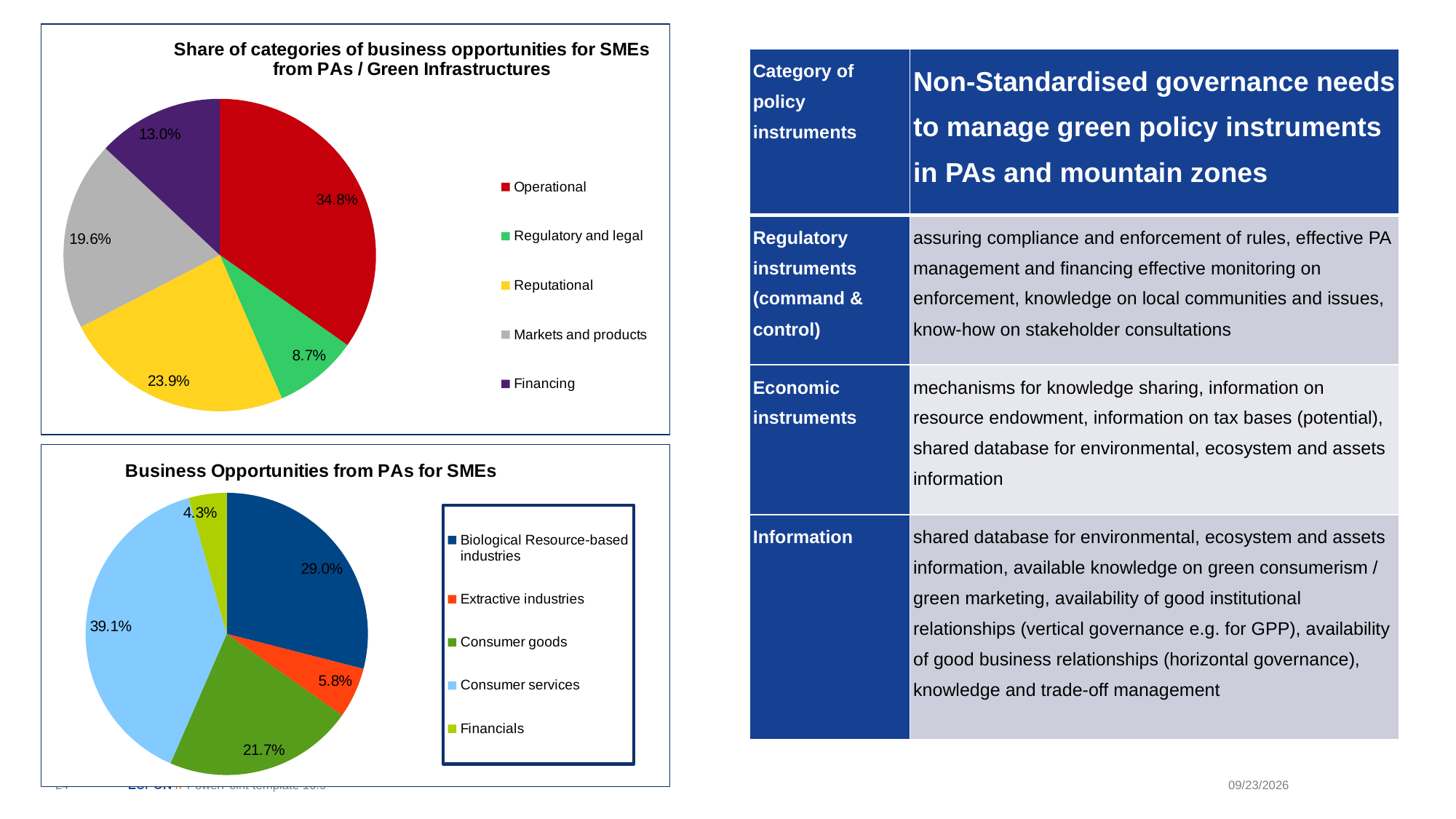
In the top chart, what is the difference between the Reputational share and the Financing share? 10.9% In the bottom chart, what share do Extractive industries have? 5.8% In the top chart, 'Share of categories of business opportunities for SMEs from PAs / Green Infrastructures', what share does Operational have? 34.8% In the top chart, what share does Markets and products have? 19.6% What type of chart is the bottom chart, 'Business Opportunities from PAs for SMEs'? Pie chart In the top chart, which category has the largest share? Operational In the bottom chart, what is the difference between the Consumer services share and the Biological Resource-based industries share? 10.1% In the bottom chart, which category has the smallest share? Financials In the bottom chart, 'Business Opportunities from PAs for SMEs', what share do Consumer services have? 39.1% In the bottom chart, which is larger: Biological Resource-based industries or Consumer goods? Biological Resource-based industries In the top chart, how many categories does the legend list? 5 In the top chart, which category has the smallest share? Regulatory and legal